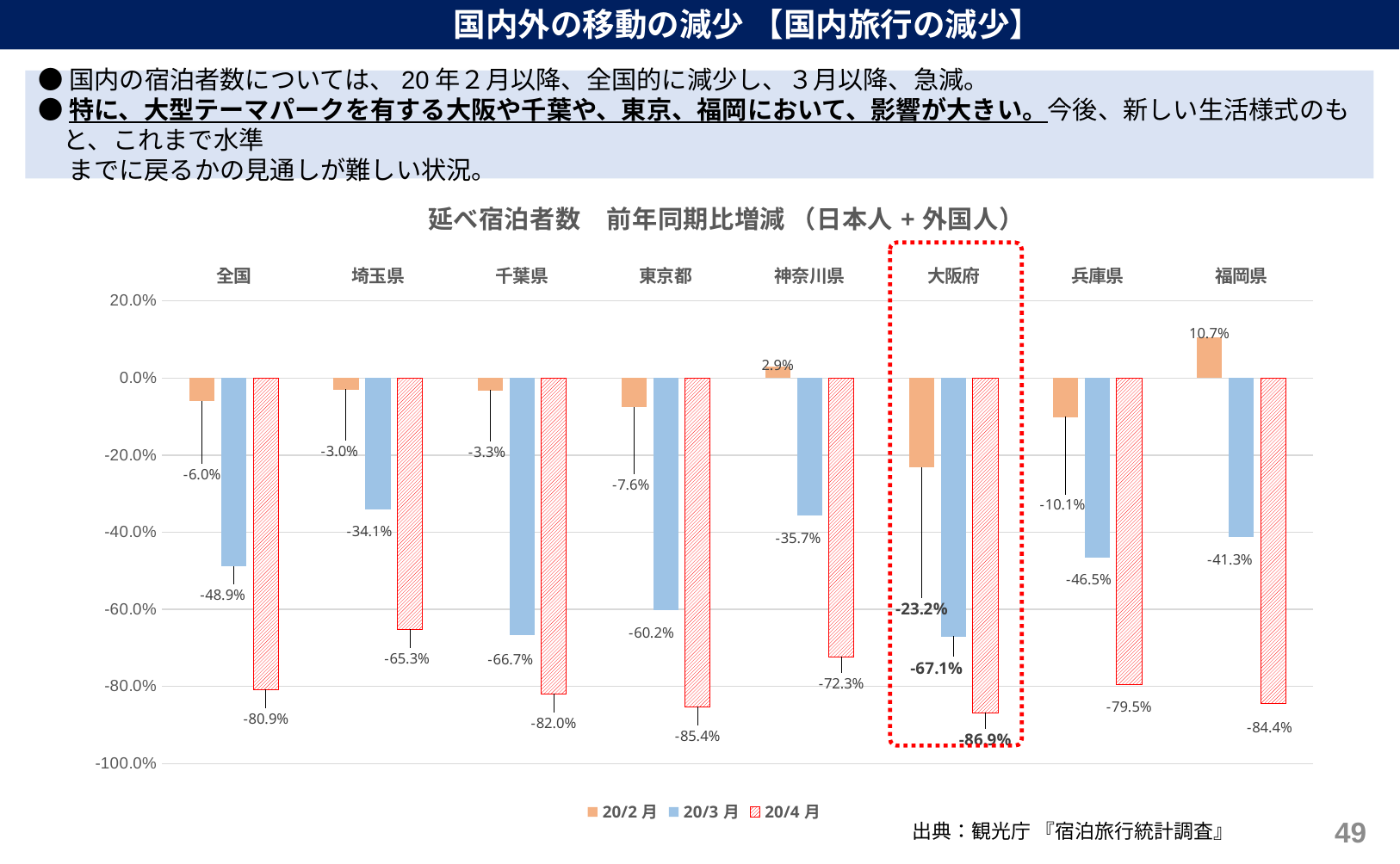
What kind of chart is shown on the slide? Bar chart What is the value for 大阪府 in the 20/4月 series? -86.9% Which category has the lowest value in the 20/3月 series? 大阪府 What is the value for 福岡県 in the 20/2月 series? 10.7% Which category has the highest value in the 20/2月 series? 福岡県 Which prefecture has the lowest value in the 20/4月 series? 大阪府 What is the value for 千葉県 in the 20/3月 series? -66.7% How many categories (regions) are shown on the x axis? 8 Which is larger, the 20/3月 value for 埼玉県 or the 20/3月 value for 東京都? 埼玉県 How many series does the legend list? 3 What is the value for 神奈川県 in the 20/2月 series? 2.9% What is the difference between the 20/3月 and 20/4月 values for 全国? 32.0 percentage points